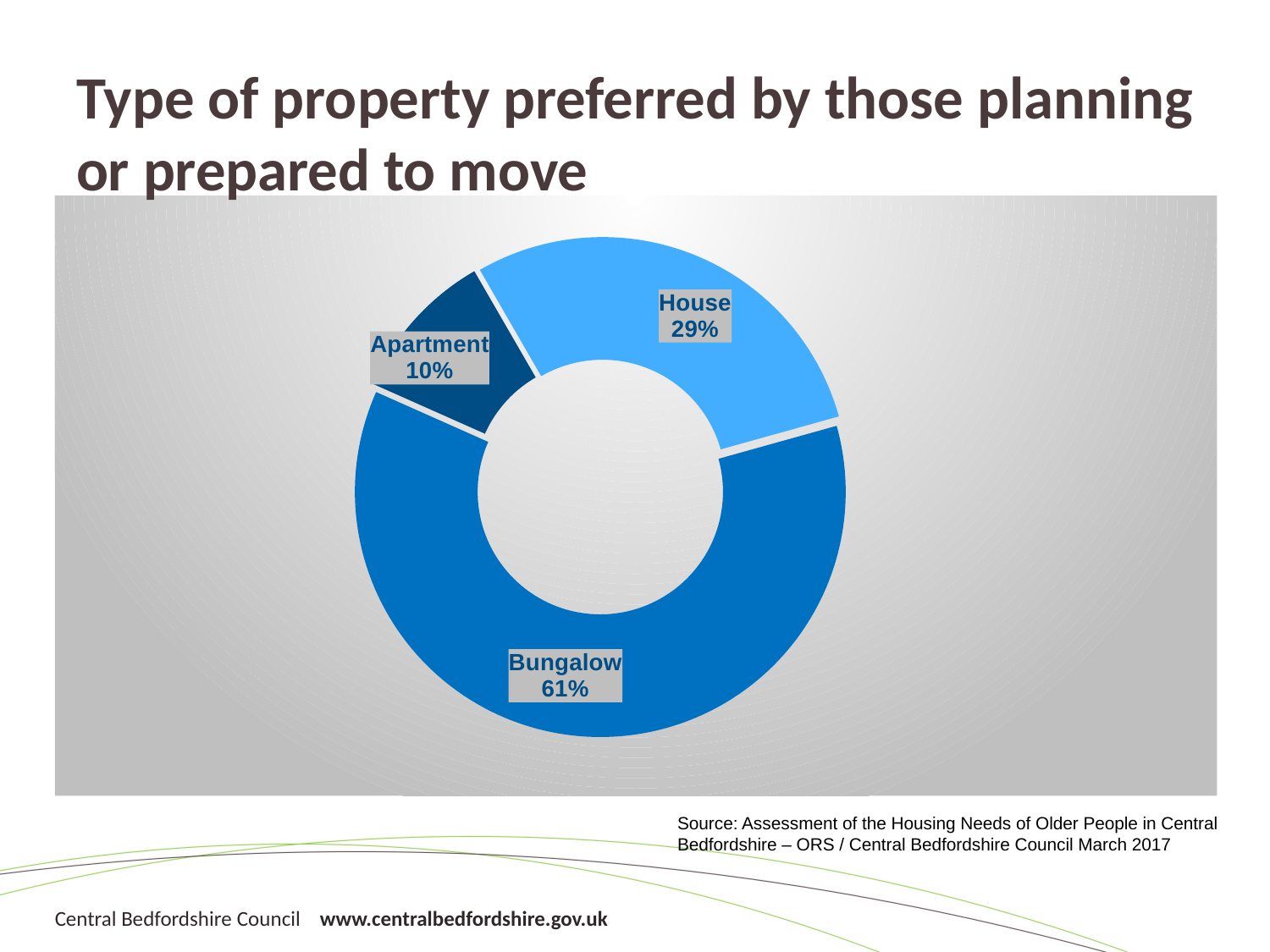
What share of those planning or prepared to move prefer a bungalow? 61% How many percentage points higher is the share preferring a bungalow than the share preferring a house? 32 percentage points Which property type's segment is shown in the darkest blue? Apartment What share of those planning or prepared to move prefer a house? 29% How many percentage points higher is the share preferring a house than the share preferring an apartment? 19 percentage points What kind of chart is shown on the slide? Doughnut (pie) chart What is the title of the slide containing the chart? Type of property preferred by those planning or prepared to move Which property type is preferred by the largest share of those planning or prepared to move? Bungalow Which property type is preferred by the smallest share of those planning or prepared to move? Apartment What share of those planning or prepared to move prefer an apartment? 10% Which is larger: the share preferring a house or the share preferring an apartment? House How many property types are shown in the chart? 3